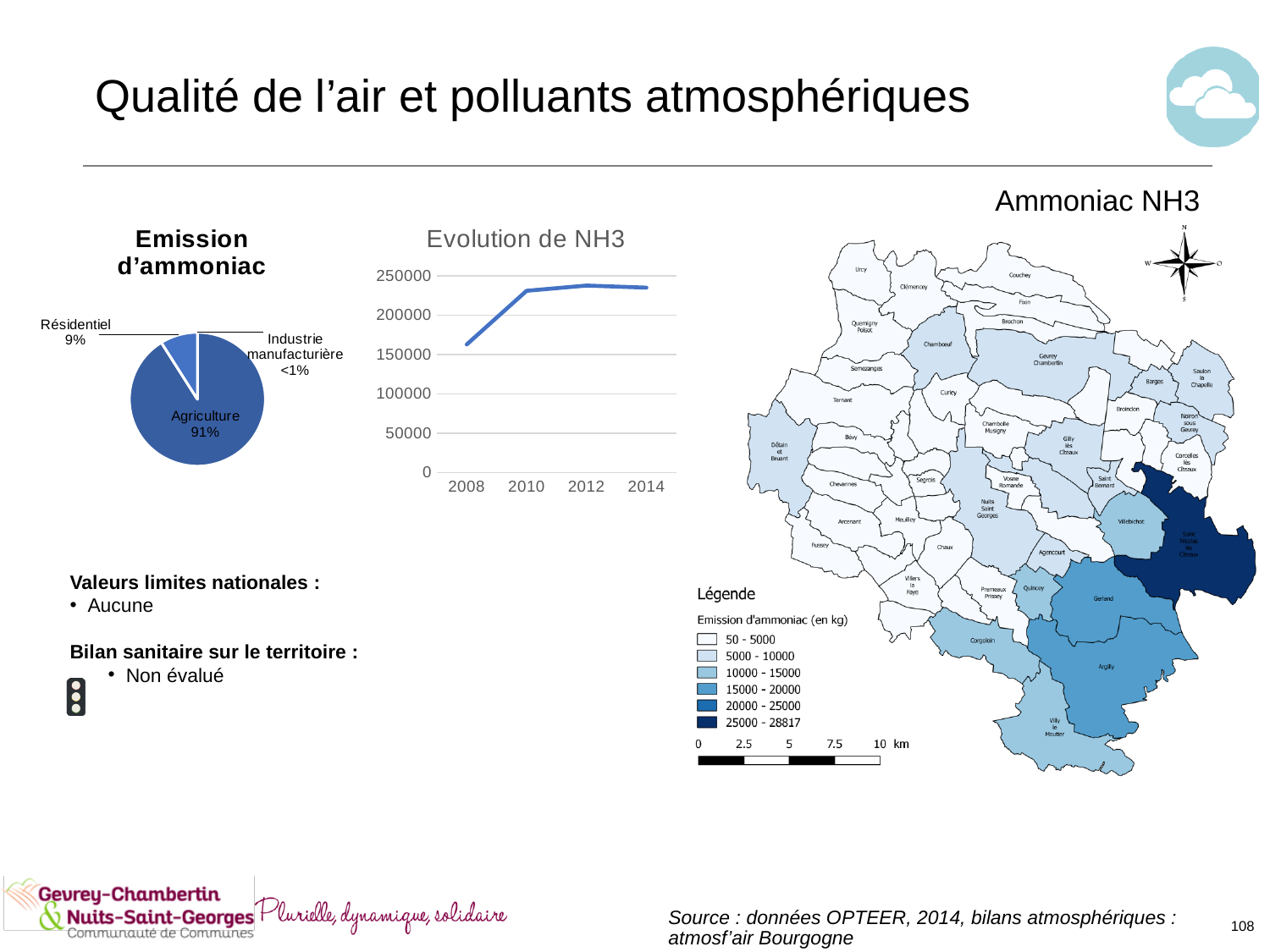
What kind of chart is 'Emission d'ammoniac'? Pie chart What kind of chart is 'Evolution de NH3'? Line chart In the pie chart 'Emission d'ammoniac', how many percentage points larger is Agriculture's share than Résidentiel's? 82 In the chart 'Evolution de NH3', is the value for 2008 greater or less than 200000? less In the pie chart 'Emission d'ammoniac', what share does Résidentiel have? 9% In the pie chart 'Emission d'ammoniac', how many sectors are shown? 3 In the pie chart 'Emission d'ammoniac', which sector has the smallest share? Industrie manufacturière In the chart 'Evolution de NH3', is the value for 2014 greater or less than 200000? greater In the pie chart 'Emission d'ammoniac', which sector has the largest share? Agriculture In the chart 'Evolution de NH3', which year has the lowest value? 2008 In the pie chart 'Emission d'ammoniac', what share is shown for Industrie manufacturière? <1% In the pie chart 'Emission d'ammoniac', what share does Agriculture have? 91%